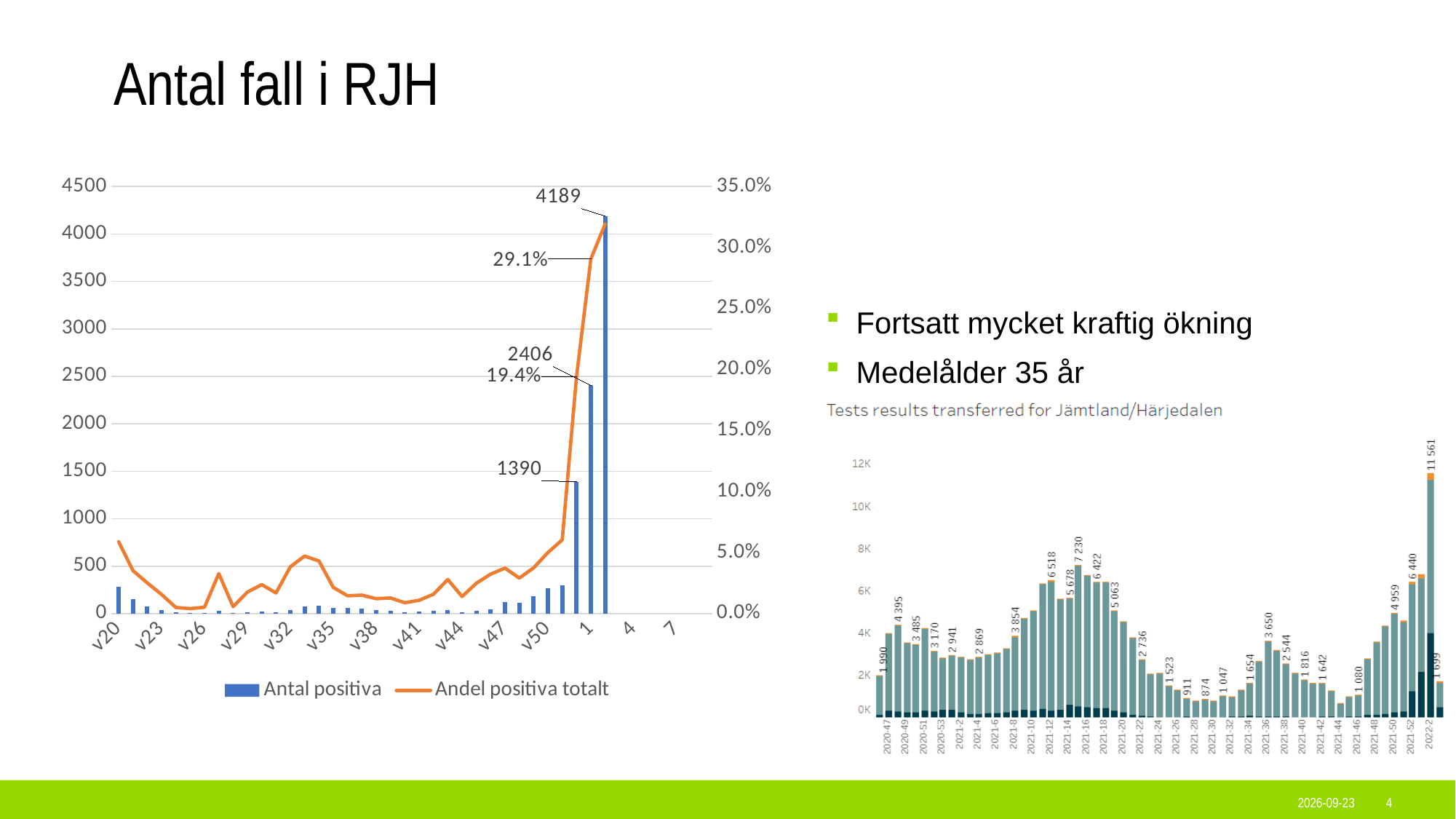
On the left chart (Antal fall i RJH), how many series does the legend list? 2 On the left chart (Antal fall i RJH), what is the difference between the labelled bar values 2406 and 1390? 1016 On the right chart (Tests results transferred for Jämtland/Härjedalen), which is larger, the bar labelled 7 230 or the bar labelled 6 518? 7 230 On the right chart (Tests results transferred for Jämtland/Härjedalen), is the value for 2021-44 greater or less than 2K? less On the left chart (Antal fall i RJH), is the Antal positiva value for v20 greater or less than 500? less On the left chart (Antal fall i RJH), do the Antal positiva bars rise or fall over the last few weeks shown? rise On the left chart (Antal fall i RJH), what is the highest percentage labelled on the Andel positiva totalt line? 29.1% On the left chart (Antal fall i RJH), what is the highest value labelled for Antal positiva? 4189 On the left chart (Antal fall i RJH), what is the difference between the two highest labelled bar values, 4189 and 2406? 1783 On the right chart (Tests results transferred for Jämtland/Härjedalen), what is the highest labelled value? 11 561 On the right chart (Tests results transferred for Jämtland/Härjedalen), what kind of chart is it? bar chart On the left chart (Antal fall i RJH), what is the name of the series drawn as an orange line? Andel positiva totalt